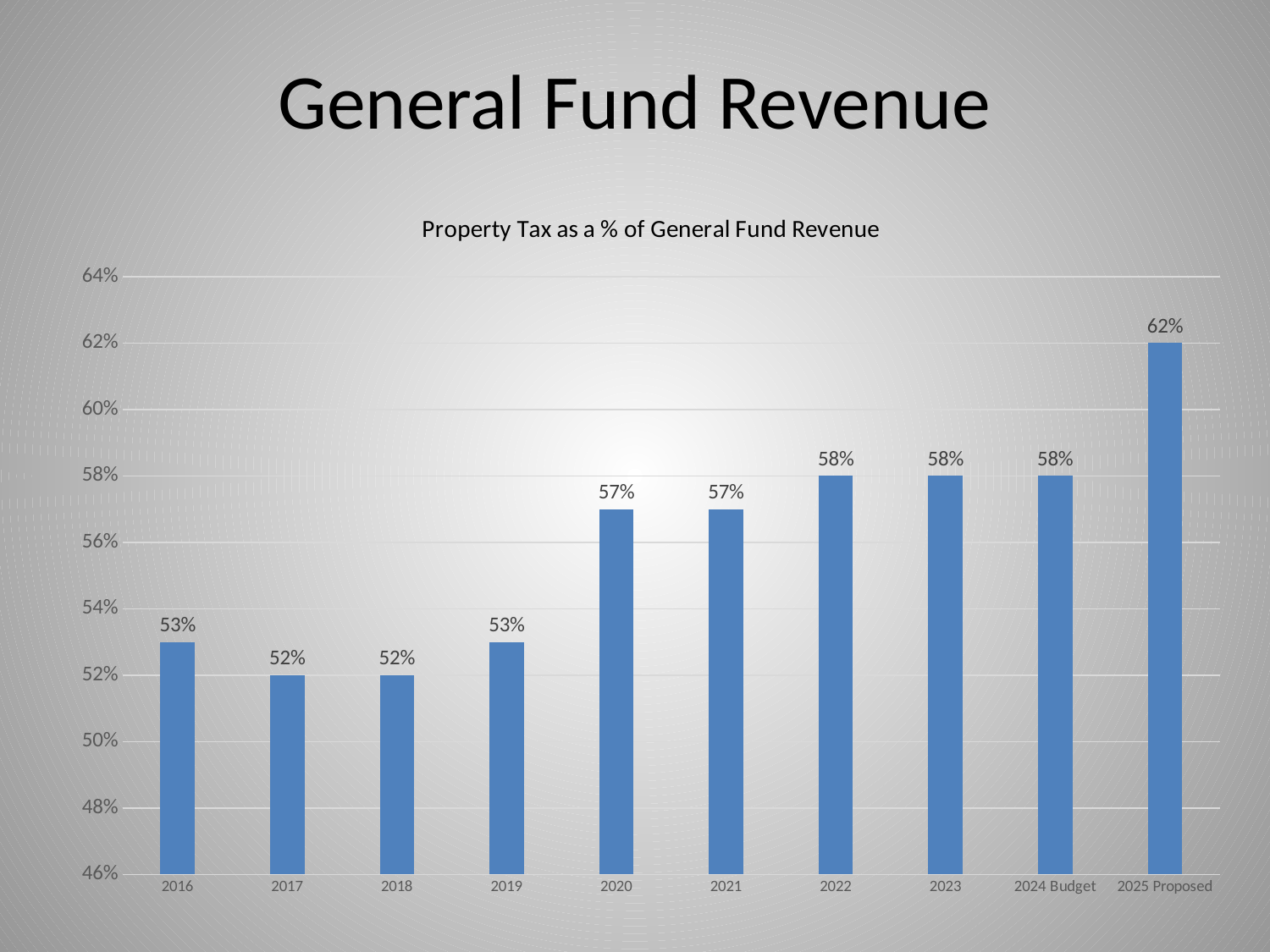
Is the value for 2025 Proposed greater or less than 60%? greater What is the value for 2020? 57% What is the value for 2024 Budget? 58% Which category has the highest value? 2025 Proposed What is the value for 2025 Proposed? 62% What is the difference between the values for 2022 and 2017? 6% How many categories are shown on the x axis? 10 What is the title of the chart? Property Tax as a % of General Fund Revenue What is the difference between the values for 2025 Proposed and 2024 Budget? 4% Which is larger, the value for 2019 or the value for 2021? 2021 What is the value for 2016? 53% What kind of chart is shown? bar chart